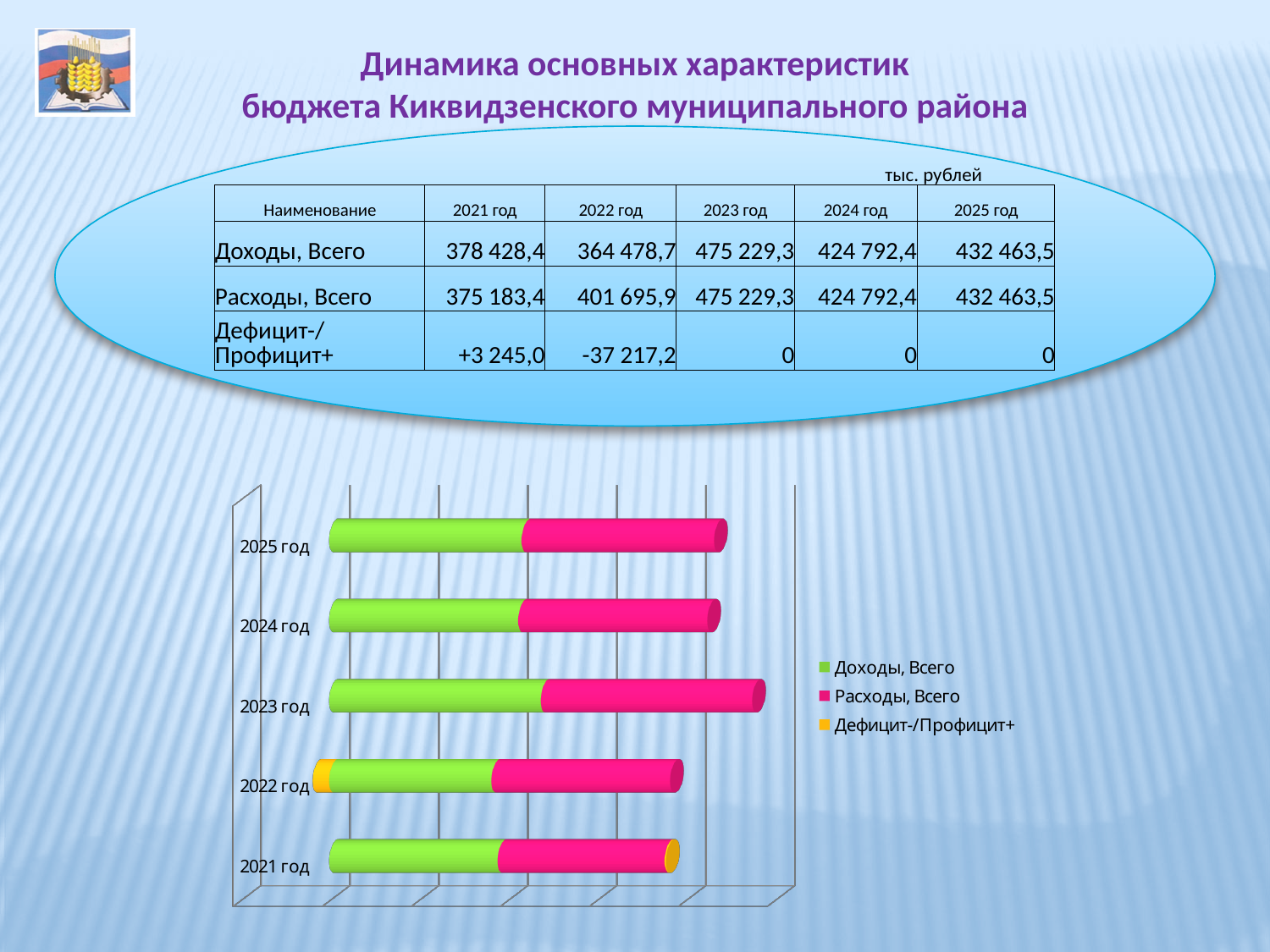
How many year categories are plotted on the chart? 5 Which series is shown in green on the chart? Доходы, Всего What is the value of Доходы, Всего for 2023 год? 475 229,3 What is the difference between Доходы, Всего in 2023 год and 2022 год? 110 750,6 What is the value of Дефицит-/Профицит+ for 2021 год? +3 245,0 What kind of chart is shown at the bottom of the slide? bar chart Which year has the longest stacked bar on the chart? 2023 год How many series does the chart legend list? 3 Which year category appears at the top of the chart? 2025 год What is the value of Расходы, Всего for 2022 год? 401 695,9 Is the stacked bar for 2023 год longer or shorter than the bar for 2022 год? longer